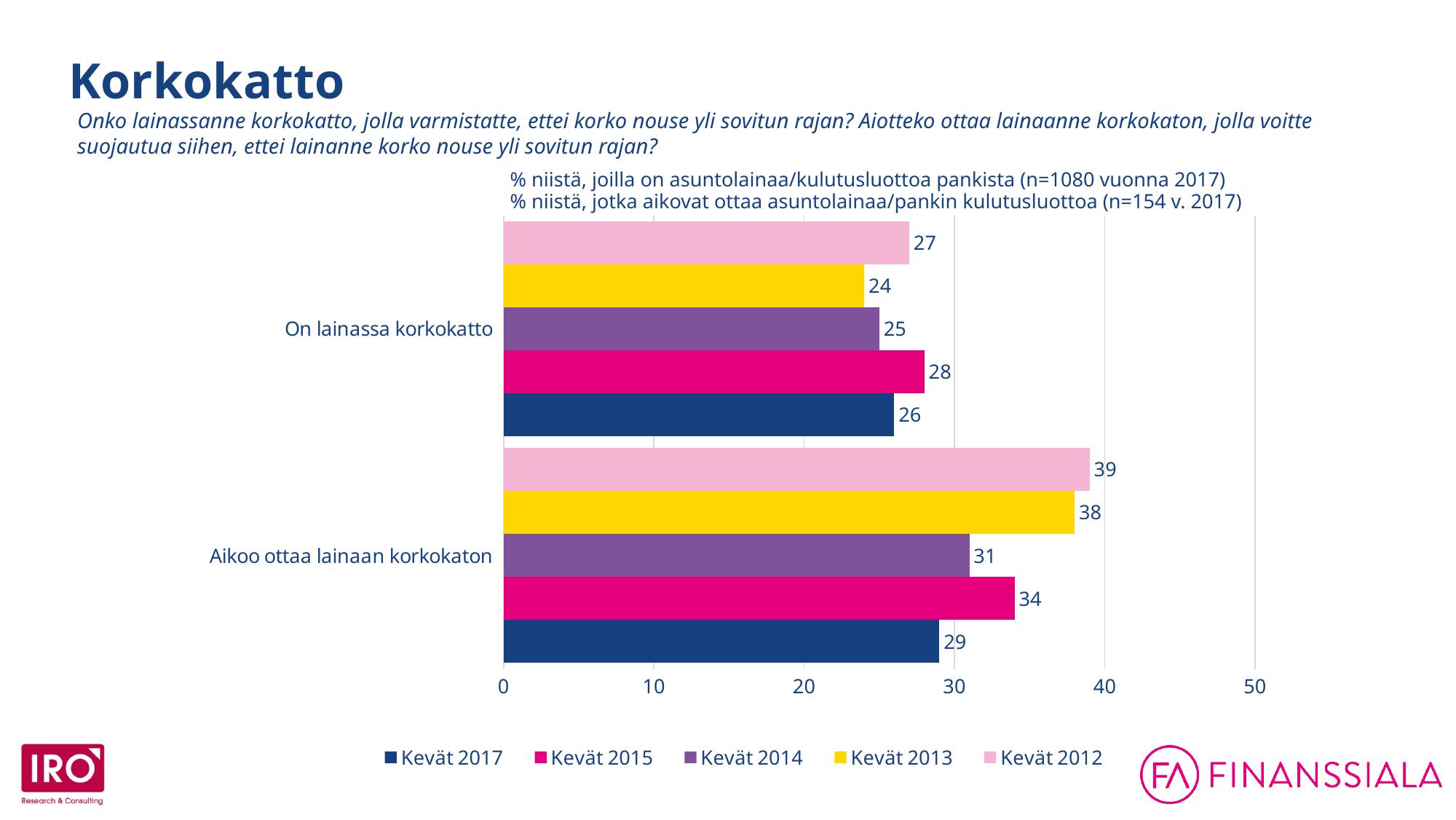
Which series has the lowest value in the 'Aikoo ottaa lainaan korkokaton' category? Kevät 2017 What is the difference between the Kevät 2015 and Kevät 2017 values in the 'Aikoo ottaa lainaan korkokaton' category? 5 How many series does the legend list? 5 What is the value for Kevät 2014 in the 'Aikoo ottaa lainaan korkokaton' category? 31 Which series has the highest value in the 'On lainassa korkokatto' category? Kevät 2015 What is the value for Kevät 2017 in the 'On lainassa korkokatto' category? 26 What is the title of the slide? Korkokatto Which is larger: the Kevät 2013 value for 'On lainassa korkokatto' or the Kevät 2013 value for 'Aikoo ottaa lainaan korkokaton'? Aikoo ottaa lainaan korkokaton How many categories are shown on the chart? 2 Is the Kevät 2012 value for 'Aikoo ottaa lainaan korkokaton' greater or less than 30? greater What kind of chart is shown on the slide? Bar chart What is the value for Kevät 2012 in the 'Aikoo ottaa lainaan korkokaton' category? 39